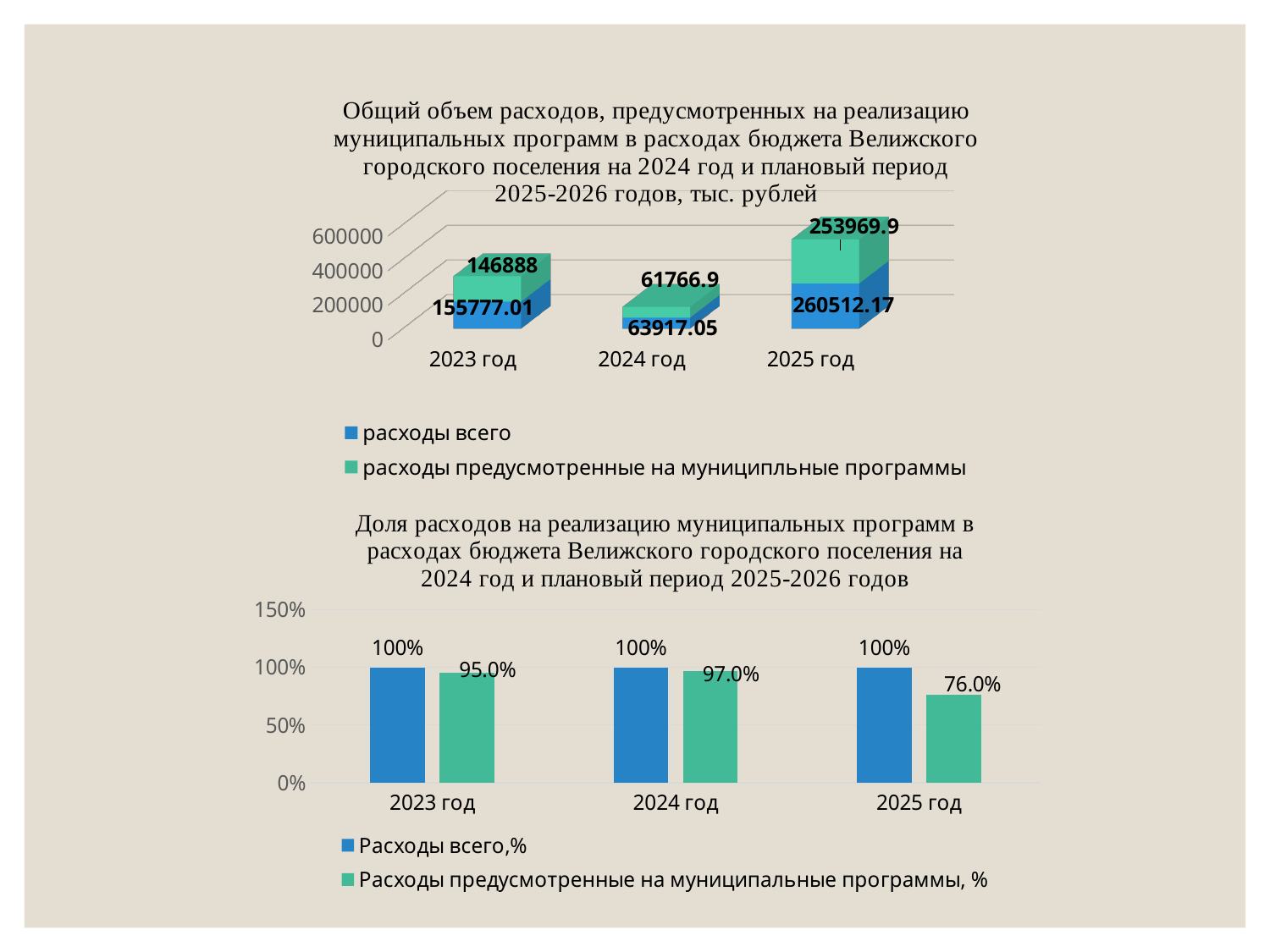
In the bottom chart, which year has the highest value of 'Расходы предусмотренные на муниципальные программы, %'? 2024 год In the top chart, what is the value of 'расходы предусмотренные на муниципльные программы' for 2025 год? 253969.9 In the top chart, what is the value of 'расходы всего' for 2023 год? 155777.01 In the bottom chart, how many year categories are shown on the x axis? 3 In the bottom chart, what is the value of 'Расходы предусмотренные на муниципальные программы, %' for 2025 год? 76.0% What kind of chart is the bottom chart? bar chart In the top chart, how many series does the legend list? 2 In the top chart, what is the value of 'расходы всего' for 2024 год? 63917.05 In the top chart, what is the difference between 'расходы всего' and 'расходы предусмотренные на муниципльные программы' for 2024 год? 2150.15 In the top chart, which year has the highest value of 'расходы предусмотренные на муниципльные программы'? 2025 год In the bottom chart, what is the value of 'Расходы предусмотренные на муниципальные программы, %' for 2023 год? 95.0% In the top chart, which year has the lowest value of 'расходы всего'? 2024 год